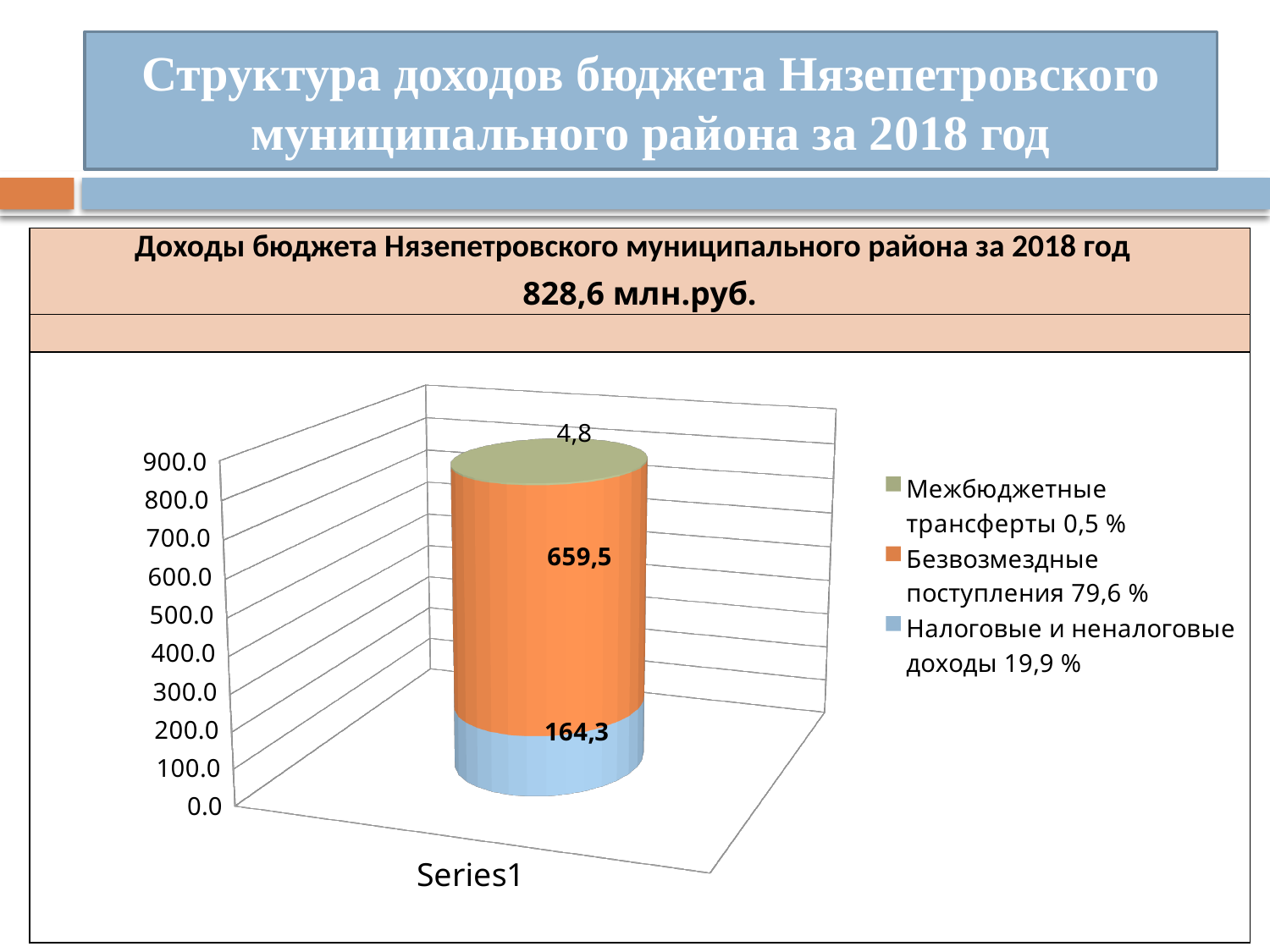
Which segment of the stacked bar has the smallest value? Межбюджетные трансферты What is the value of the Налоговые и неналоговые доходы segment in the stacked bar? 164,3 What is the value of the Безвозмездные поступления segment in the stacked bar? 659,5 What is the value of the Межбюджетные трансферты segment in the stacked bar? 4,8 How many series does the legend list? 3 What is the difference between the Безвозмездные поступления value and the Налоговые и неналоговые доходы value? 495,2 Which is larger: the Налоговые и неналоговые доходы segment or the Межбюджетные трансферты segment? Налоговые и неналоговые доходы What is the category label shown on the x axis of the chart? Series1 Which segment of the stacked bar has the largest value? Безвозмездные поступления What kind of chart is shown on the slide? Stacked bar chart What percentage share is shown in the legend for Безвозмездные поступления? 79,6 % What is the total of the stacked bar (sum of all three segments)? 828,6